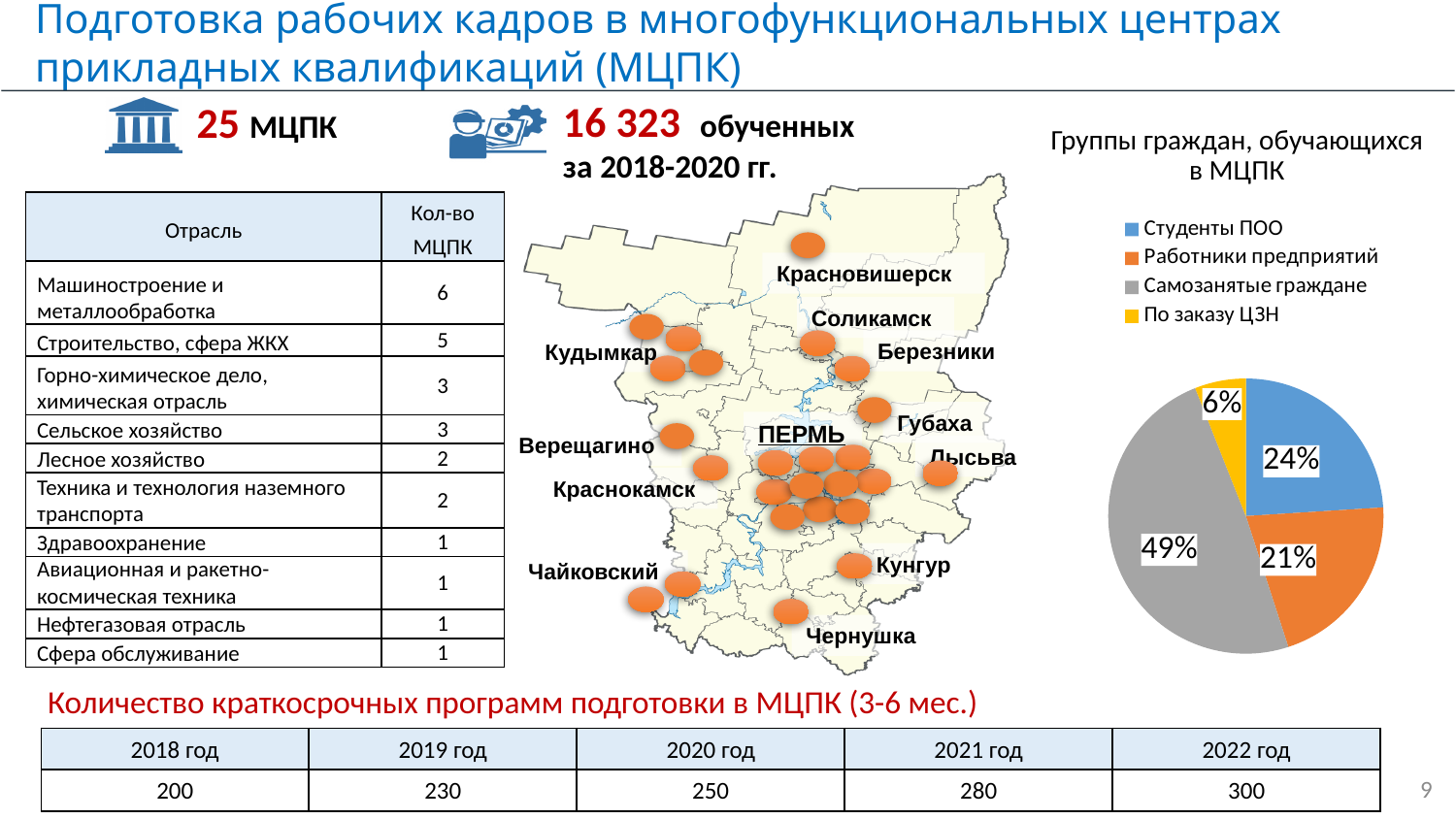
How many entries does the legend of the pie chart 'Группы граждан, обучающихся в МЦПК' list? 4 In the pie chart 'Группы граждан, обучающихся в МЦПК', what share is labelled for Студенты ПОО? 24% In the pie chart 'Группы граждан, обучающихся в МЦПК', what share is labelled for Самозанятые граждане? 49% In the pie chart 'Группы граждан, обучающихся в МЦПК', which is larger: the share for Студенты ПОО or for Работники предприятий? Студенты ПОО In the pie chart 'Группы граждан, обучающихся в МЦПК', what colour is the slice for Самозанятые граждане? gray In the pie chart 'Группы граждан, обучающихся в МЦПК', which group has the largest share? Самозанятые граждане In the pie chart 'Группы граждан, обучающихся в МЦПК', which group has the smallest share? По заказу ЦЗН How many slices does the pie chart 'Группы граждан, обучающихся в МЦПК' have? 4 In the pie chart 'Группы граждан, обучающихся в МЦПК', what is the difference in percentage points between Самозанятые граждане and Студенты ПОО? 25 In the pie chart 'Группы граждан, обучающихся в МЦПК', what share is labelled for По заказу ЦЗН? 6% What kind of chart is shown under the heading 'Группы граждан, обучающихся в МЦПК'? pie chart In the pie chart 'Группы граждан, обучающихся в МЦПК', what share is labelled for Работники предприятий? 21%